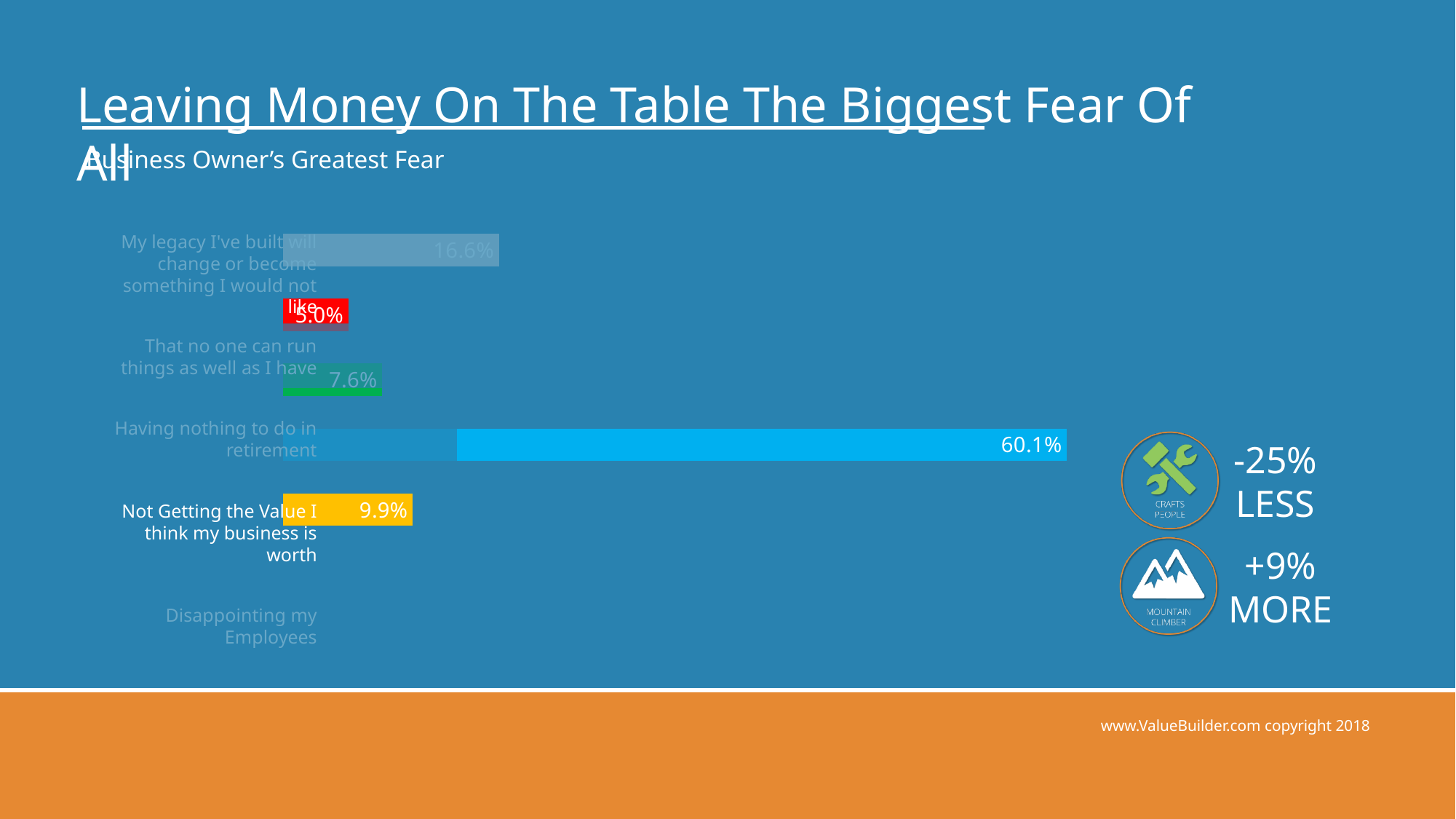
How many bars with data labels are plotted in the chart? 5 What is the lowest value labelled on any bar in the chart? 5.0% What value is labelled on the red bar? 5.0% What kind of chart is shown on the slide? Bar chart What value is labelled on the light blue bar? 60.1% Which bar is longer, the yellow bar or the green bar? The yellow bar What colour is the longest bar in the chart? Light blue What is the highest value labelled on any bar in the chart? 60.1% What is the difference between the grey bar's value (16.6%) and the green bar's value (7.6%)? 9.0 percentage points What value is labelled on the yellow bar? 9.9% What is the difference between the largest labelled value (60.1%) and the yellow bar's value (9.9%)? 50.2 percentage points What is the title of the chart? Business Owner's Greatest Fear